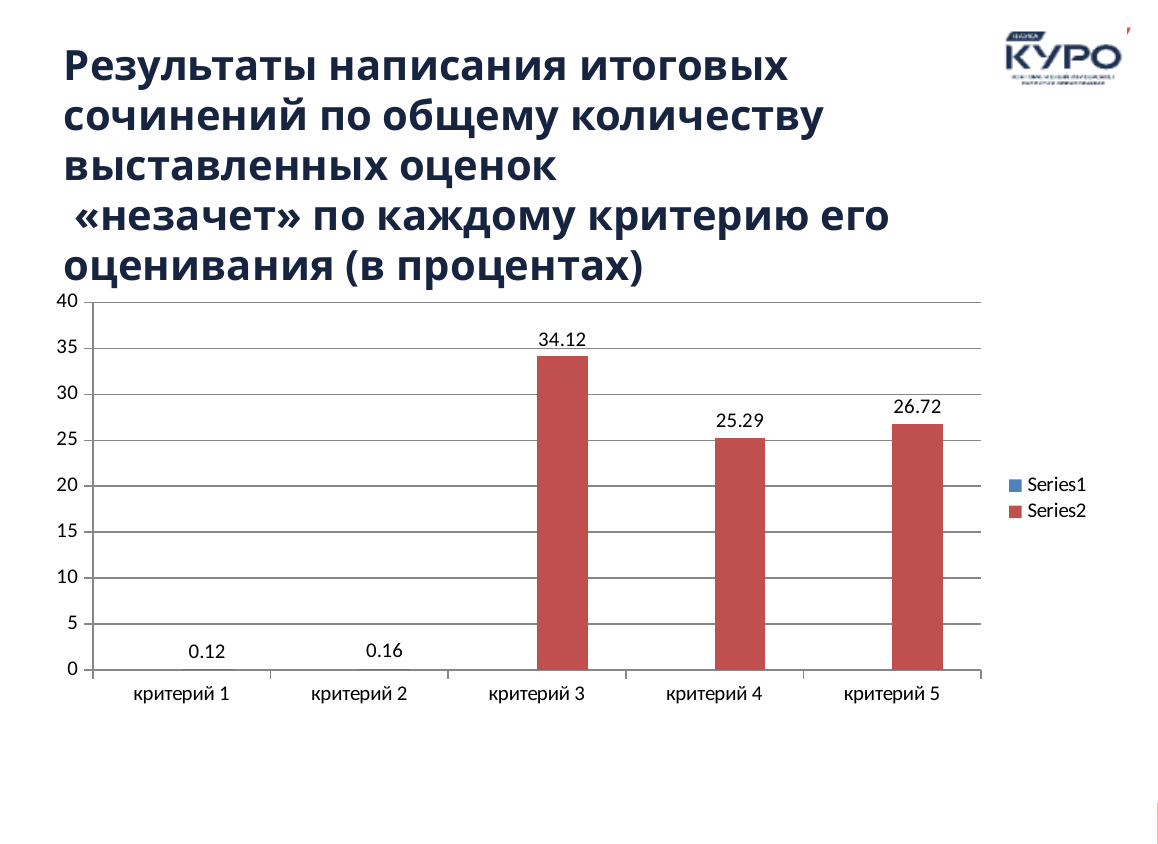
What is the value for критерий 4? 25.29 What is the value for критерий 1? 0.12 What is the value for критерий 3? 34.12 Which category has the lowest value? критерий 1 How many categories are shown on the x axis? 5 What is the difference between the values for критерий 3 and критерий 5? 7.4 What kind of chart is shown on the slide? bar chart What is the value for критерий 2? 0.16 Is the value for критерий 3 greater or less than 30? greater Which is larger, the value for критерий 4 or критерий 5? критерий 5 Which category has the highest value? критерий 3 How many series does the legend list? 2